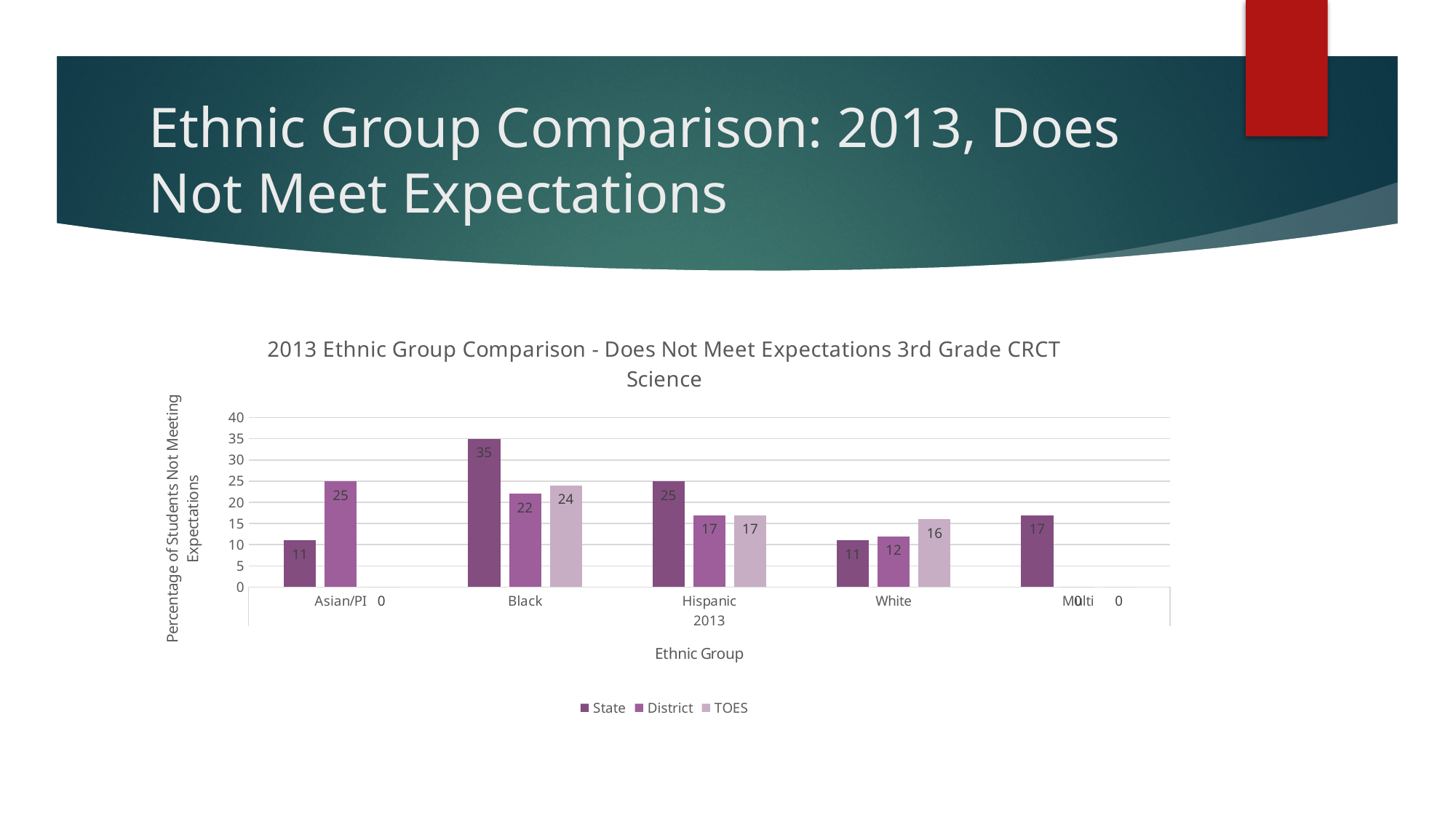
What is the label of the x axis? Ethnic Group What is the District value for Asian/PI? 25 Which ethnic group has the highest State value? Black What is the State value for Multi? 17 How many series does the legend list? 3 What is the TOES value for White? 16 How many ethnic groups are shown on the x axis? 5 Which is larger for Hispanic, the State value or the District value? State What is the difference between the State and District values for Black? 13 What is the State value for Black? 35 What kind of chart is shown on the slide? Bar chart